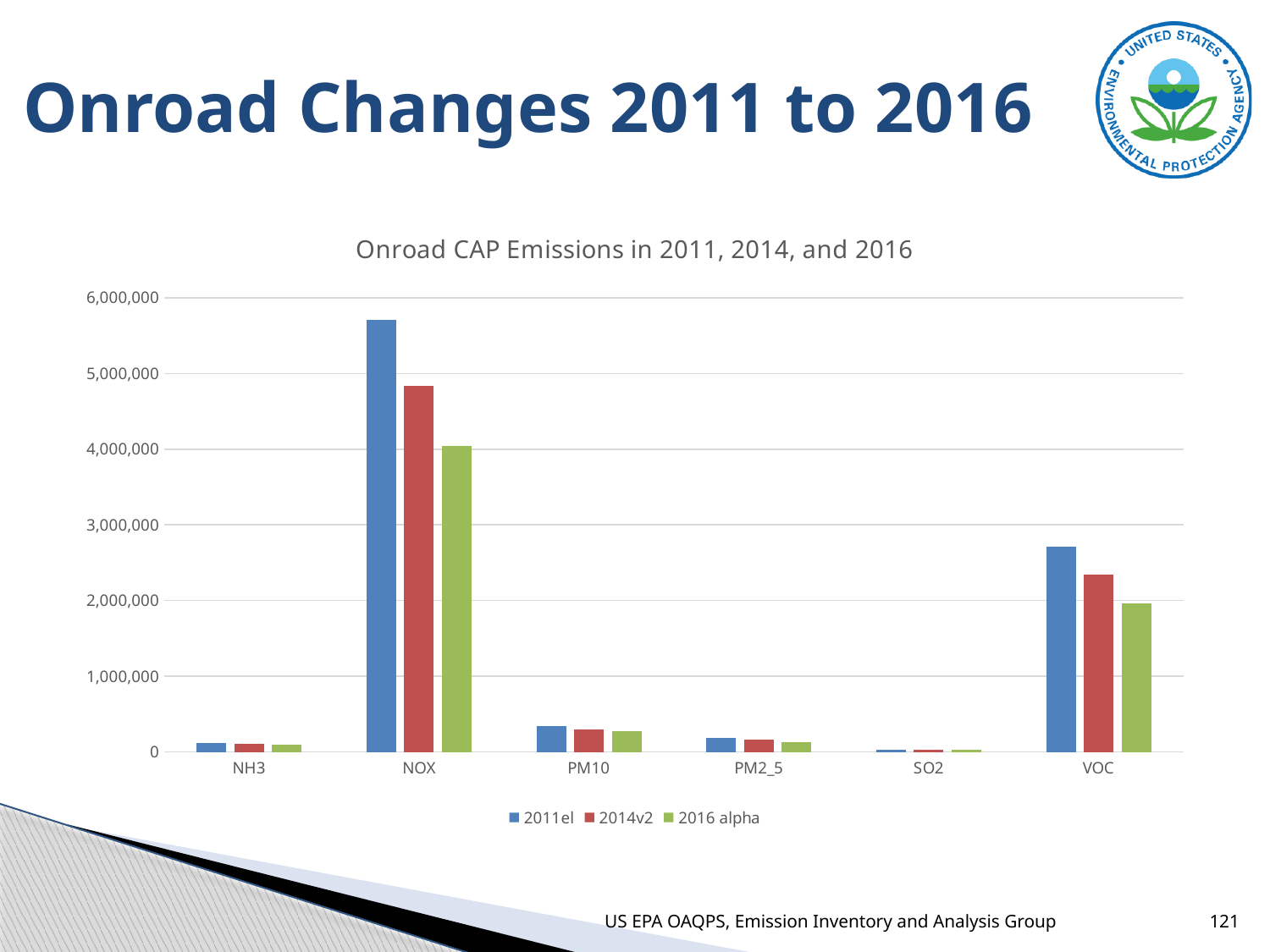
What kind of chart is shown on the slide? bar chart Is the 2011el value for NOX greater or less than 5,000,000? greater What is the title of the chart? Onroad CAP Emissions in 2011, 2014, and 2016 For NOX, which series has the larger value, 2011el or 2016 alpha? 2011el Is the 2011el value for VOC greater or less than 3,000,000? less How many pollutant categories are shown on the x axis? 6 Is the 2016 alpha value for NOX greater or less than 5,000,000? less Which pollutant has the lowest emissions for the 2016 alpha series? SO2 For VOC, do the values fall or rise from 2011el to 2014v2 to 2016 alpha? fall Which pollutant has the highest emissions for the 2011el series? NOX How many series does the legend list? 3